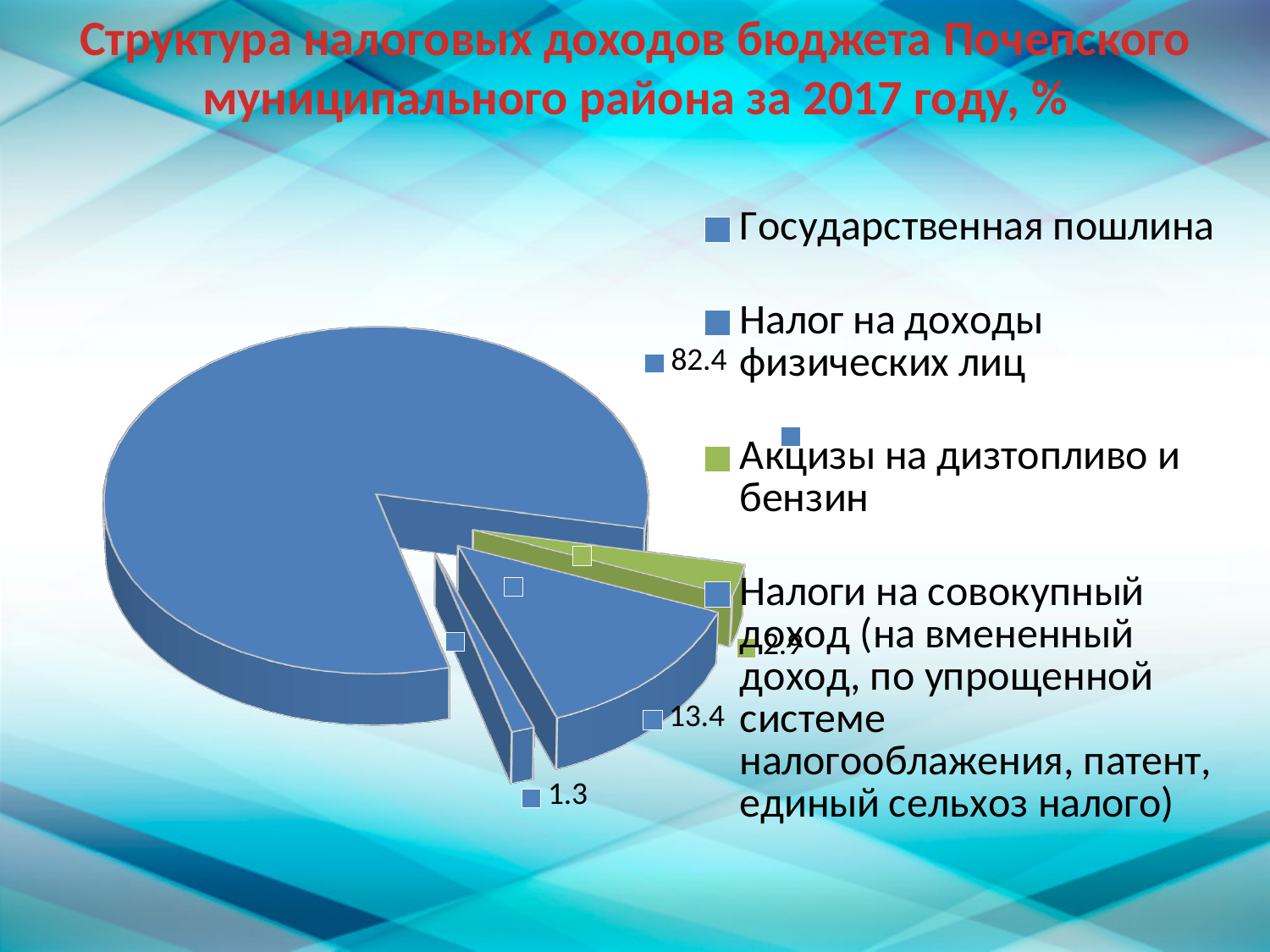
What kind of chart is shown on the slide? pie chart Is the value of the largest slice greater or less than 50? greater What is the second-largest value labelled on the pie chart? 13.4 How many entries does the chart legend list? 4 What is the difference between the largest slice (82.4) and the slice labelled 13.4? 69.0 Which legend category is shown in green on the pie chart? Акцизы на дизтопливо и бензин What is the value of the largest slice of the pie chart? 82.4 What is the title of the chart on the slide? Структура налоговых доходов бюджета Почепского муниципального района за 2017 году, % How many slices does the pie chart have? 4 Which is larger, the slice labelled 13.4 or the slice labelled 1.3? 13.4 What is the smallest value labelled on the pie chart? 1.3